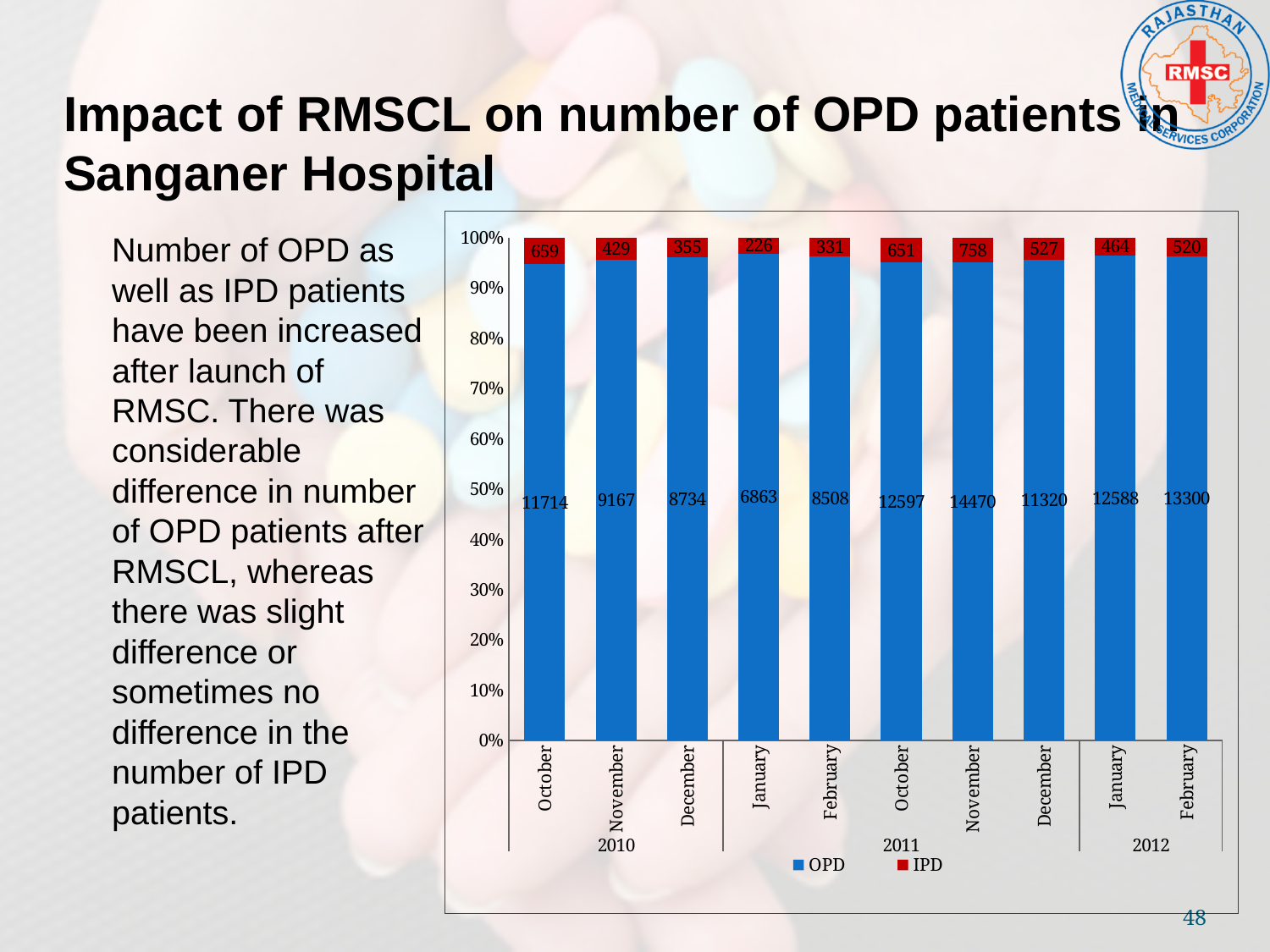
What is the OPD value for October 2010? 11714 Which month has the highest OPD value? November 2011 How many months are shown on the x axis? 10 How many series does the legend list? 2 What is the IPD value for November 2011? 758 Which month has the lowest IPD value? January 2011 Which is larger, the IPD value for October 2010 or the IPD value for October 2011? October 2010 What kind of chart is shown on the slide? Stacked bar chart What is the IPD value for January 2011? 226 What is the difference between the OPD values for November 2011 and January 2011? 7607 What is the total of OPD and IPD for December 2011? 11847 What is the OPD value for February 2012? 13300